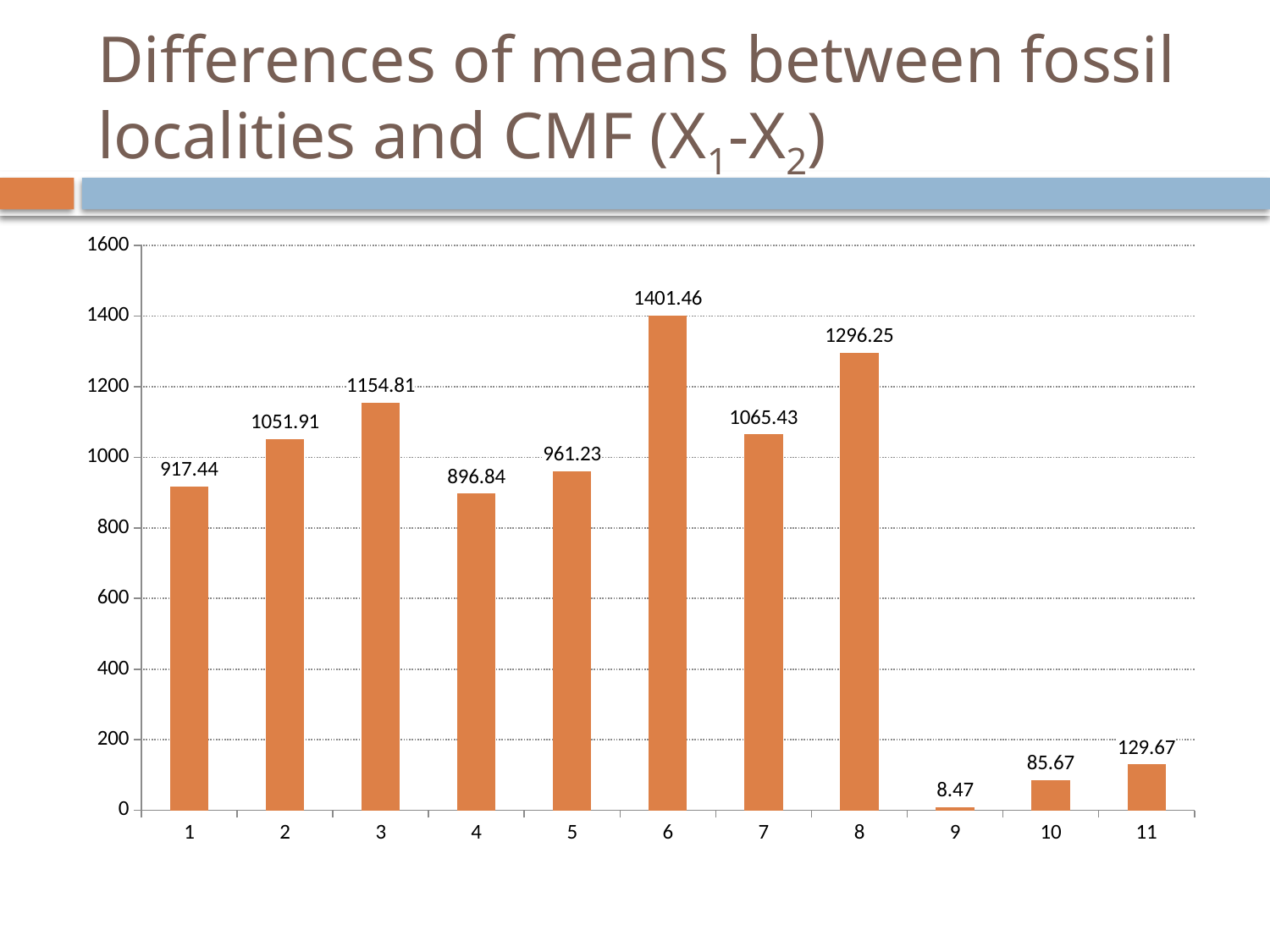
Which is larger, the value for category 2 or the value for category 7? 7 Which category has the lowest value? 9 What is the difference between the values for category 11 and category 10? 44 How many categories are shown on the x axis? 11 Which category has the highest value? 6 What is the title of the slide containing the chart? Differences of means between fossil localities and CMF (X1-X2) What is the difference between the values for category 6 and category 8? 105.21 What is the value for category 3? 1154.81 What is the value for category 6? 1401.46 Is the value for category 4 greater or less than 1000? less What is the value for category 9? 8.47 What kind of chart is shown on the slide? bar chart